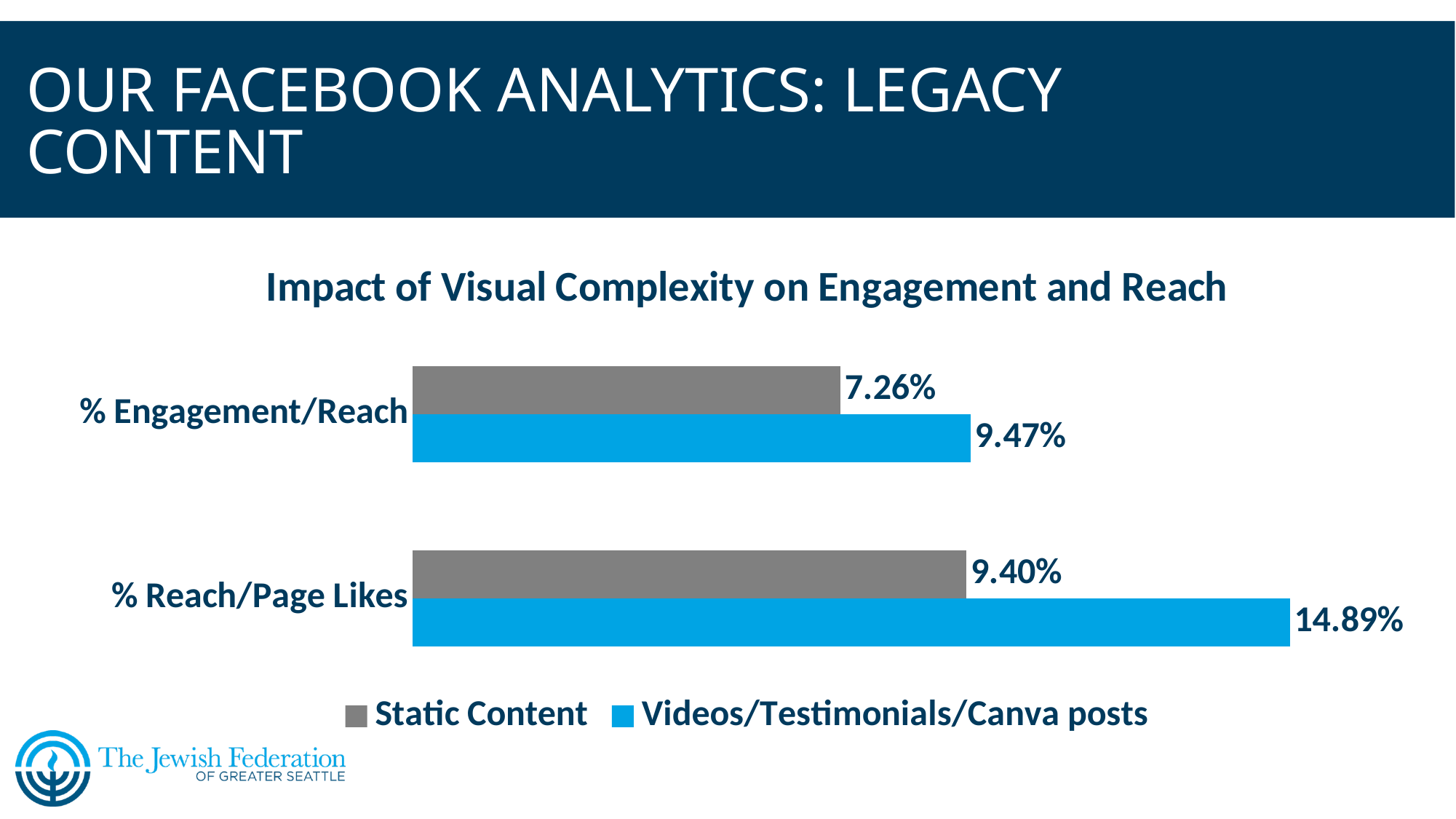
What is the value for Videos/Testimonials/Canva posts in the % Engagement/Reach category? 9.47% Which bar has the lowest value on the chart? Static Content, % Engagement/Reach Which series has the highest value in the % Reach/Page Likes category? Videos/Testimonials/Canva posts What is the value for Videos/Testimonials/Canva posts in the % Reach/Page Likes category? 14.89% How many series does the legend list? 2 What is the difference between Videos/Testimonials/Canva posts and Static Content in the % Reach/Page Likes category? 5.49% What is the difference between Videos/Testimonials/Canva posts and Static Content in the % Engagement/Reach category? 2.21% Which is larger: Static Content for % Reach/Page Likes or Videos/Testimonials/Canva posts for % Engagement/Reach? Videos/Testimonials/Canva posts for % Engagement/Reach What is the value for Static Content in the % Engagement/Reach category? 7.26% What is the value for Static Content in the % Reach/Page Likes category? 9.40% How many categories are shown on the chart? 2 What type of chart is shown on the slide? Bar chart